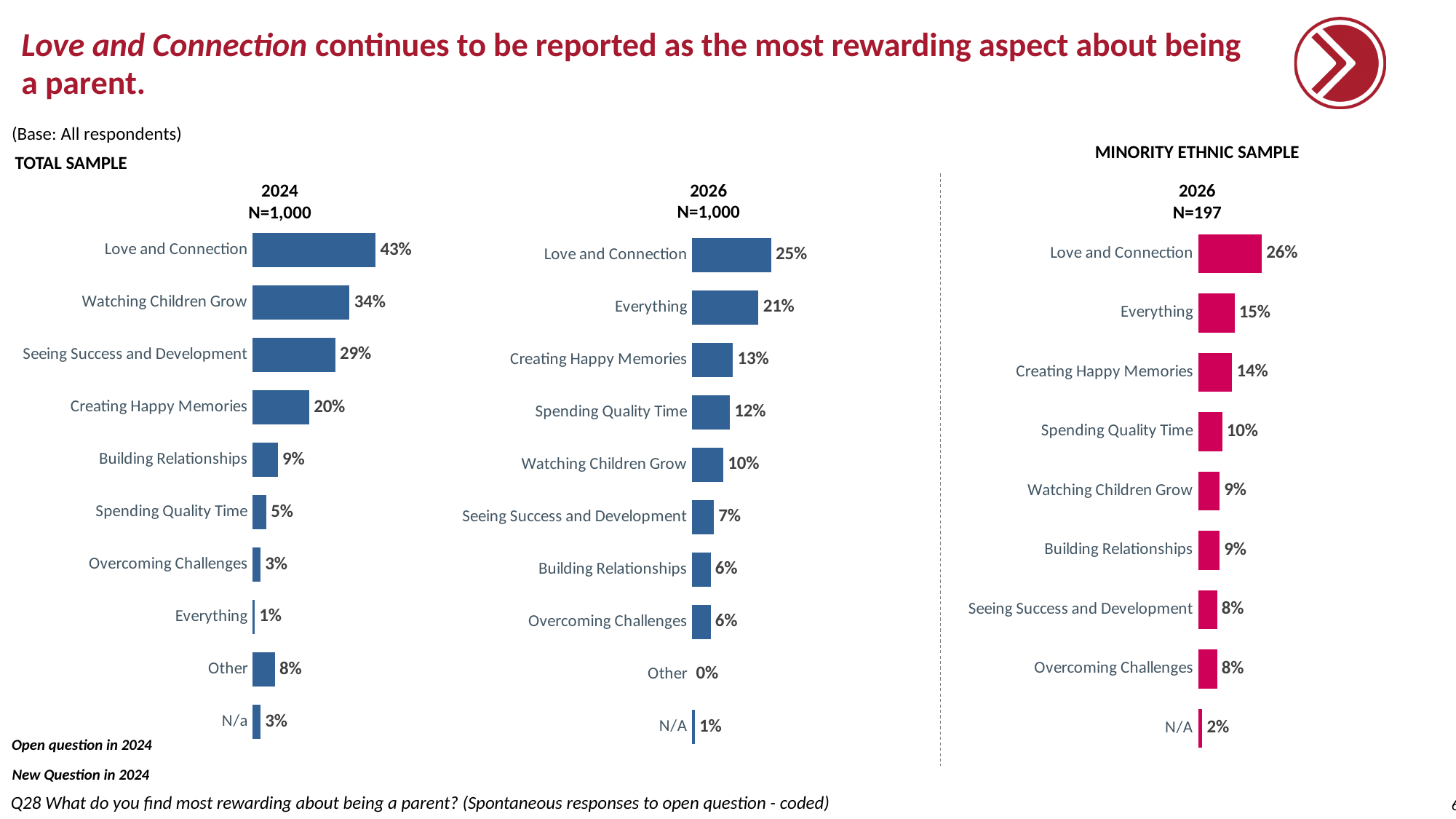
In the 2024 N=1,000 chart, which category has the lowest value? Everything In the 2026 N=1,000 chart, which category has the lowest value? Other What type of chart is the 2024 N=1,000 chart? Bar chart Which is larger: Watching Children Grow in the 2024 N=1,000 chart or Watching Children Grow in the 2026 N=1,000 chart? 2024 N=1,000 In the 2024 N=1,000 chart, what is the difference between Love and Connection and Watching Children Grow? 9% In the 2024 N=1,000 chart, what is the value for Love and Connection? 43% In the 2026 N=1,000 chart, what is the difference between Love and Connection and Everything? 4% How many categories are shown in the Minority Ethnic Sample 2026 N=197 chart? 9 In the Minority Ethnic Sample 2026 N=197 chart, what is the value for Creating Happy Memories? 14% What colour are the bars in the Minority Ethnic Sample 2026 N=197 chart? Red In the 2026 N=1,000 chart, what is the value for Everything? 21% In the 2024 N=1,000 chart, which category has the highest value? Love and Connection